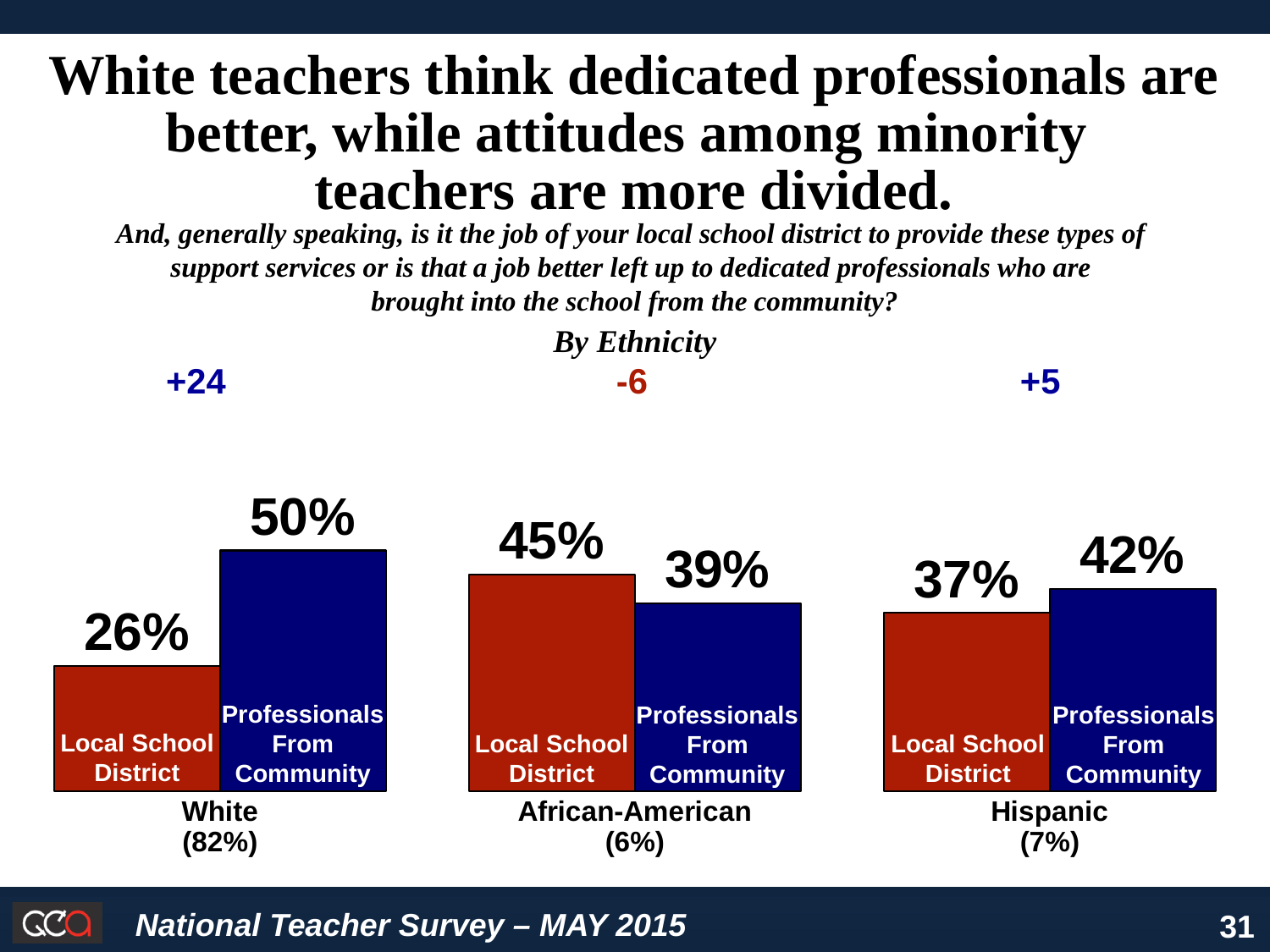
What percentage of White teachers say support services are better left to Professionals From Community? 50% Which ethnicity group has the highest percentage for Professionals From Community? White Among Hispanic teachers, which is larger: Local School District or Professionals From Community? Professionals From Community How many ethnicity groups are shown in the chart? 3 What percentage of Hispanic teachers say support services are better left to Professionals From Community? 42% Which ethnicity group has the lowest percentage for Local School District? White What percentage of White teachers say support services are the job of the Local School District? 26% What net difference is shown above the African-American group? -6 What is the difference between the Professionals From Community and Local School District percentages among White teachers? 24 percentage points What percentage of African-American teachers say support services are the job of the Local School District? 45% Among African-American teachers, which is larger: Local School District or Professionals From Community? Local School District What kind of chart is shown on the slide? Bar chart